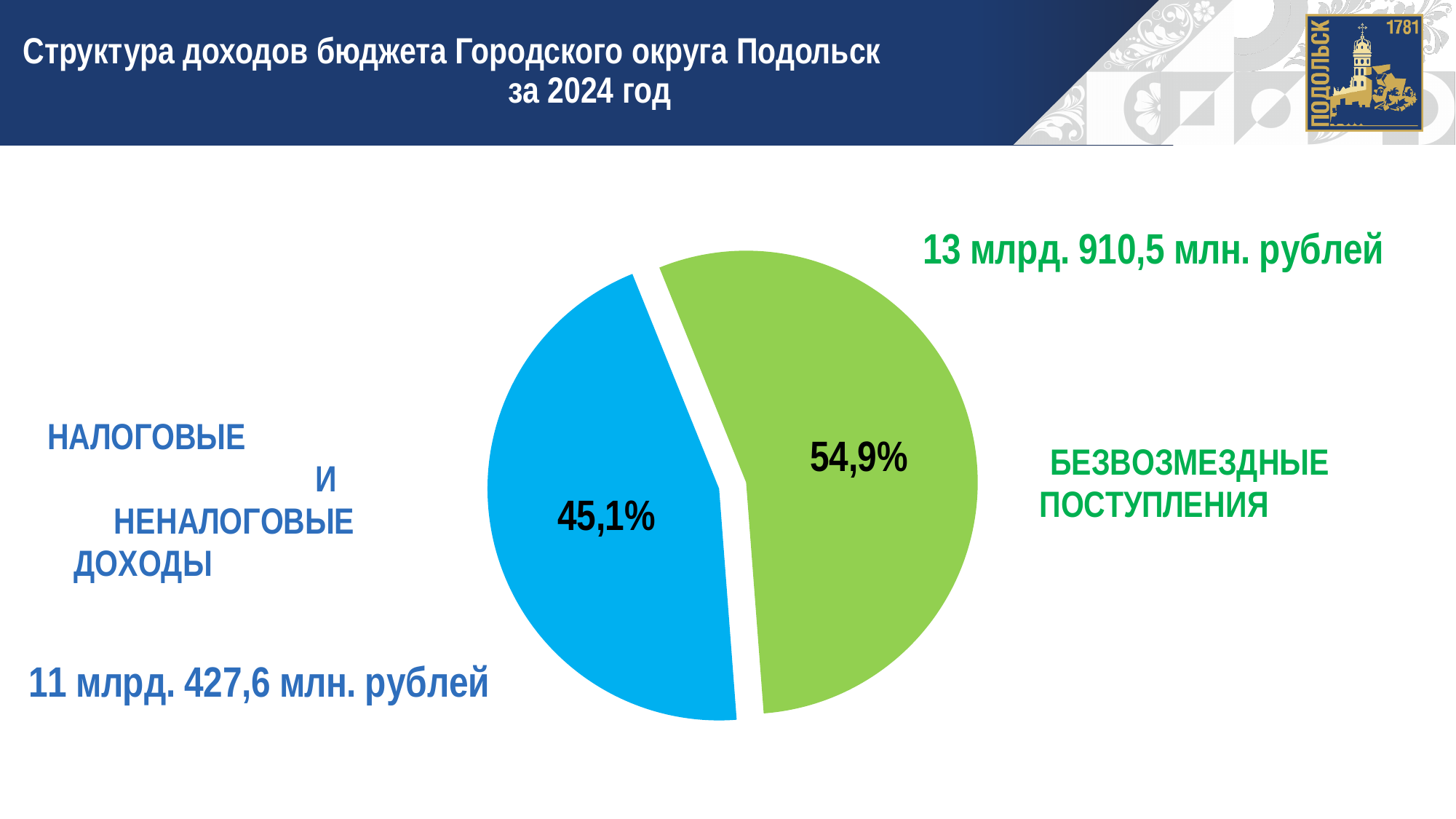
Which is larger: the share of НАЛОГОВЫЕ И НЕНАЛОГОВЫЕ ДОХОДЫ or the share of БЕЗВОЗМЕЗДНЫЕ ПОСТУПЛЕНИЯ? БЕЗВОЗМЕЗДНЫЕ ПОСТУПЛЕНИЯ What share of the pie does БЕЗВОЗМЕЗДНЫЕ ПОСТУПЛЕНИЯ represent? 54,9% What is the difference in percentage points between the share of БЕЗВОЗМЕЗДНЫЕ ПОСТУПЛЕНИЯ and the share of НАЛОГОВЫЕ И НЕНАЛОГОВЫЕ ДОХОДЫ? 9,8 How many slices does the pie chart have? 2 What is the title of the slide? Структура доходов бюджета Городского округа Подольск за 2024 год Which category has the largest share of the pie? БЕЗВОЗМЕЗДНЫЕ ПОСТУПЛЕНИЯ What share of the pie does НАЛОГОВЫЕ И НЕНАЛОГОВЫЕ ДОХОДЫ represent? 45,1% Which category has the smallest share of the pie? НАЛОГОВЫЕ И НЕНАЛОГОВЫЕ ДОХОДЫ What colour is the slice for БЕЗВОЗМЕЗДНЫЕ ПОСТУПЛЕНИЯ? Green What amount in rubles is shown for НАЛОГОВЫЕ И НЕНАЛОГОВЫЕ ДОХОДЫ? 11 млрд. 427,6 млн. рублей What kind of chart is shown on the slide? Pie chart What amount in rubles is shown for БЕЗВОЗМЕЗДНЫЕ ПОСТУПЛЕНИЯ? 13 млрд. 910,5 млн. рублей